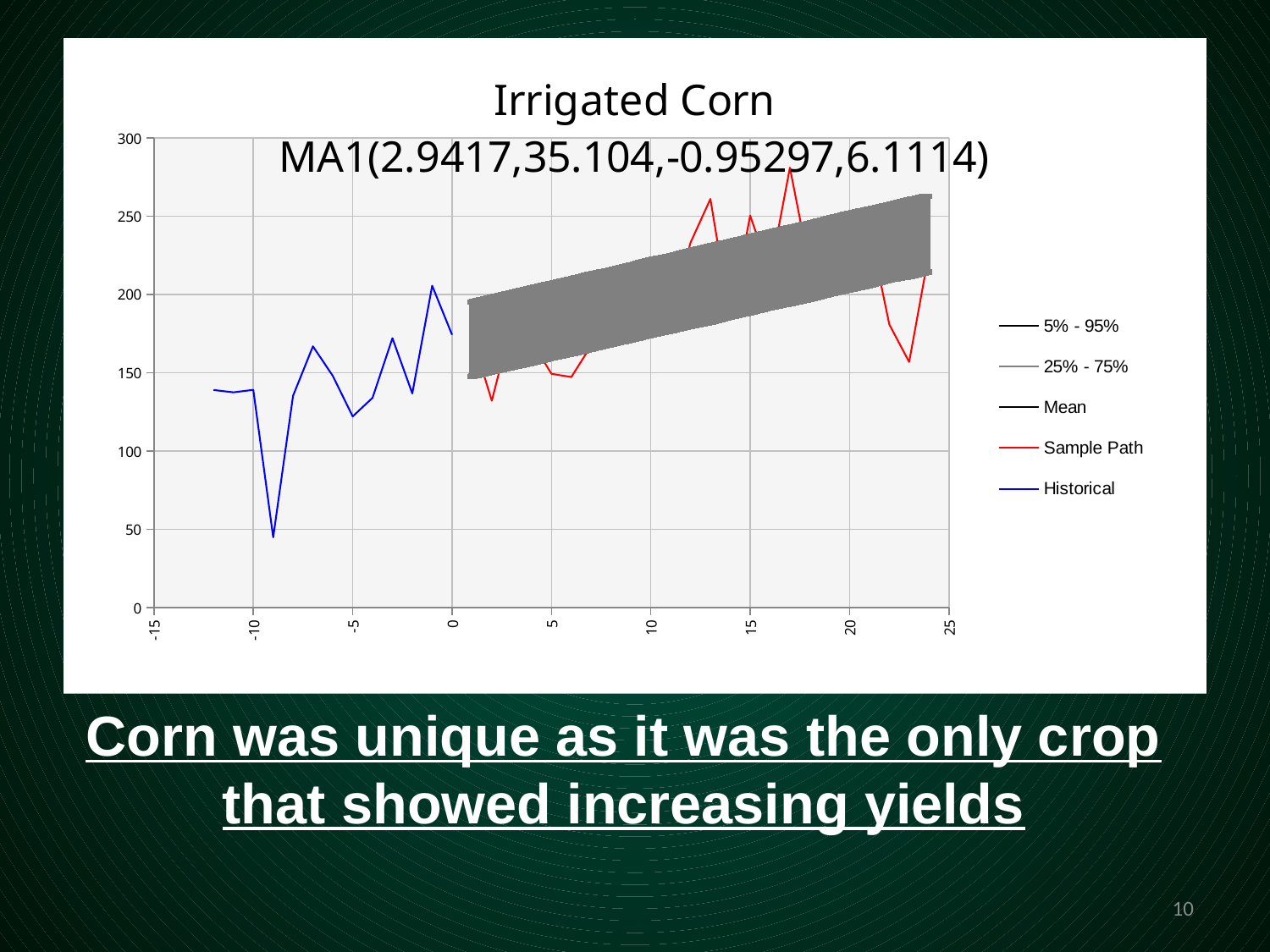
Which is larger: the Historical value at x = -1 or the Historical value at x = -9? x = -1 Does the grey forecast band (Mean) rise or fall as x increases from 0 to 25? rise How many series does the legend list? 5 Is the Historical value at x = -12 greater or less than 150? less Is the highest value of the Sample Path series greater or less than 250? greater Is the lowest value of the Historical series greater or less than 100? less What colour is the Historical series drawn in? blue What is the title of the chart (first line)? Irrigated Corn What kind of chart is shown on the slide? line chart